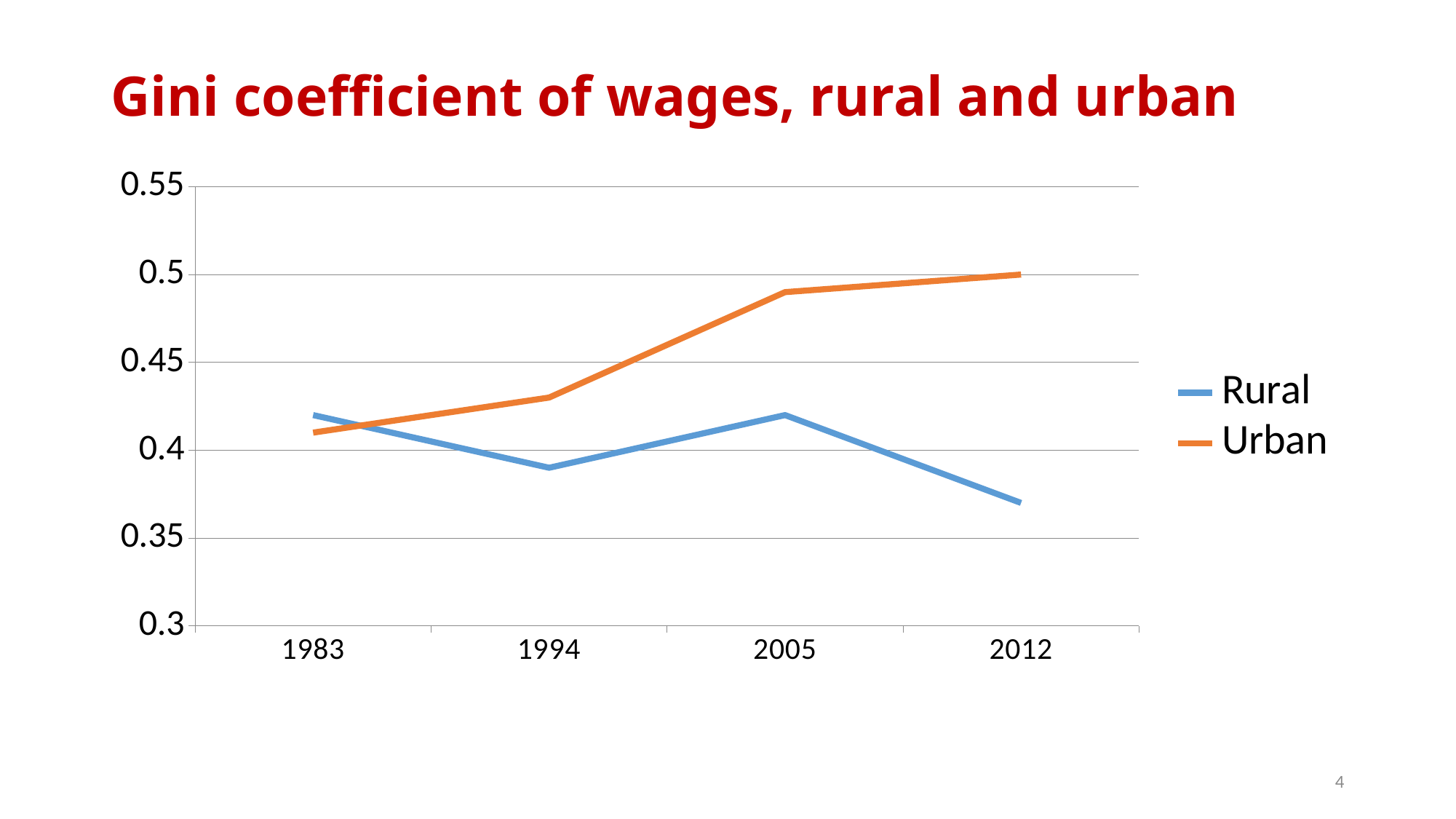
Does the Urban series rise or fall from 1983 to 2012? rise Is the Urban value for 1994 greater or less than 0.45? less Which series has the higher value in 2012, Rural or Urban? Urban What is the title of the chart? Gini coefficient of wages, rural and urban How many years are shown on the x axis? 4 How many series does the legend list? 2 In which year is the Rural series at its lowest? 2012 In which year is the Urban series at its highest? 2012 What kind of chart is shown on the slide? line chart Is the Rural value for 1994 greater or less than 0.4? less Is the Rural value for 2012 greater or less than 0.4? less